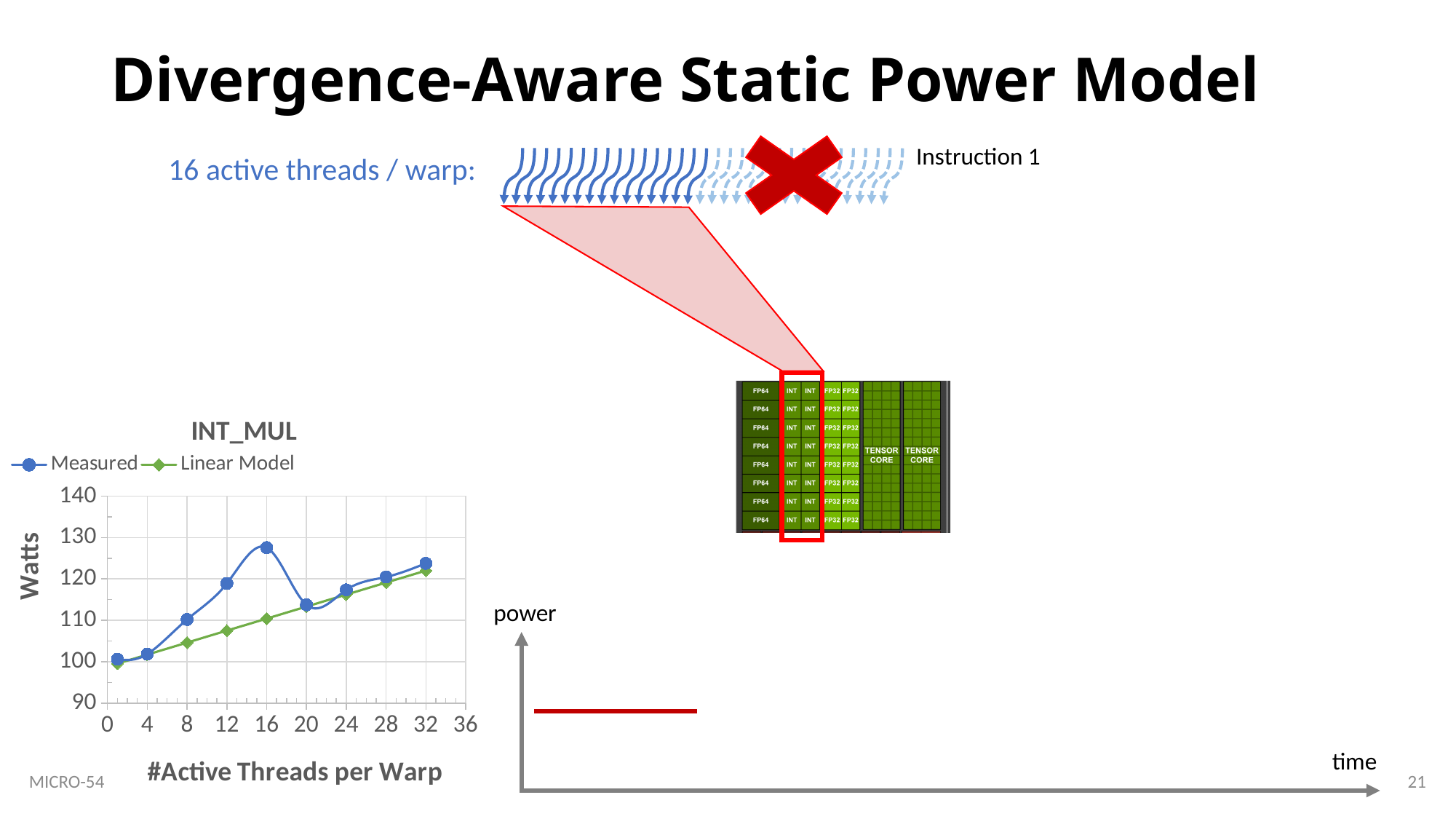
What kind of chart is the INT_MUL chart? line chart What is the y-axis label of the INT_MUL chart? Watts Is the Linear Model value at 16 active threads per warp greater or less than 120 in the INT_MUL chart? less Is the Measured value at 16 active threads per warp greater or less than 120 in the INT_MUL chart? greater In the INT_MUL chart, does the Linear Model series rise or fall as the number of active threads per warp increases? rise In the INT_MUL chart, which series has the larger value at 12 active threads per warp, Measured or Linear Model? Measured At which number of active threads per warp does the Measured series reach its highest value in the INT_MUL chart? 16 How many data points does the Measured series have in the INT_MUL chart? 9 Is the Measured value at 32 active threads per warp greater or less than 130 in the INT_MUL chart? less What are the two series named in the legend of the INT_MUL chart? Measured and Linear Model How many series does the legend of the INT_MUL chart list? 2